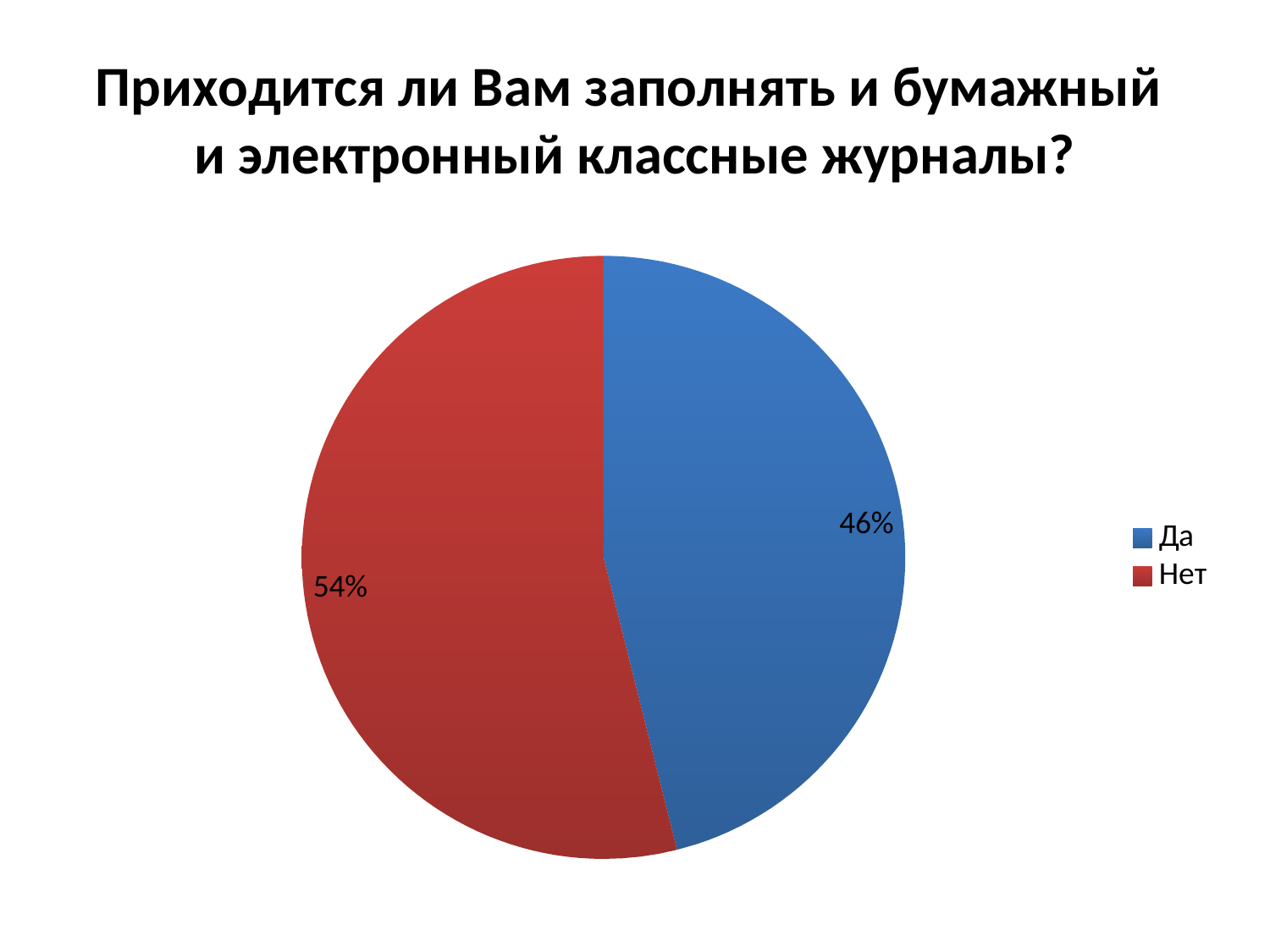
How many slices does the pie chart have? 2 What kind of chart is shown on the slide? Pie chart Which slice is the smallest in the pie chart? Да What share of the pie does the "Да" slice represent? 46% Which is larger, the "Да" slice or the "Нет" slice? Нет Which slice is the largest in the pie chart? Нет How many entries does the legend list? 2 What is the difference in percentage points between the "Нет" and "Да" slices? 8 What share of the pie does the "Нет" slice represent? 54% What is the total of the two slices shown in the pie chart? 100% What colour is the "Нет" slice? Red What is the title of the slide? Приходится ли Вам заполнять и бумажный и электронный классные журналы?